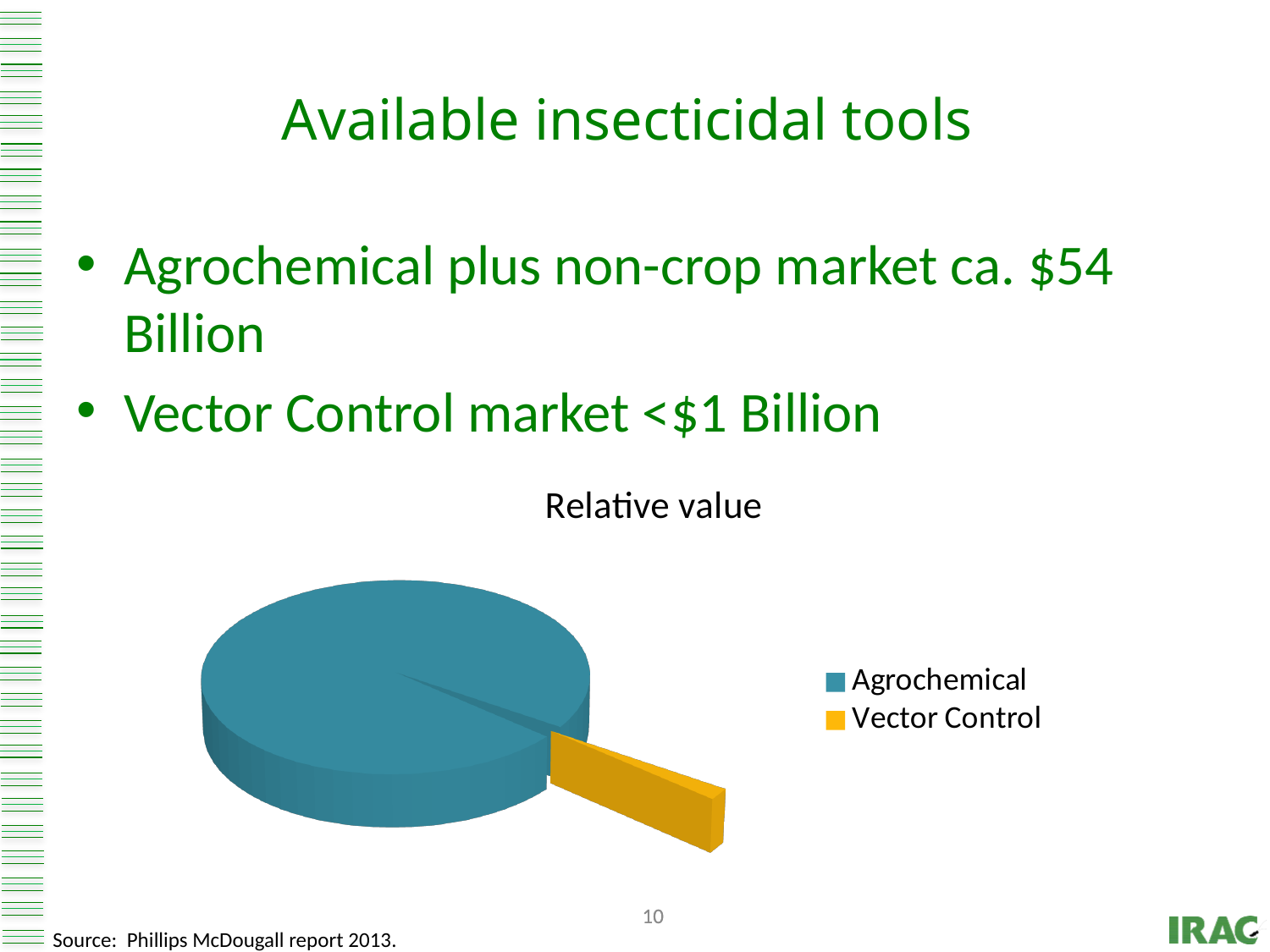
What is the title of the chart? Relative value What kind of chart is shown on the slide? pie chart Which slice of the pie chart is the largest? Agrochemical How many series does the chart legend list? 2 What colour is the Vector Control slice in the pie chart? yellow Which slice of the pie chart is the smallest? Vector Control How many slices does the pie chart have? 2 Which is larger in the pie chart, Agrochemical or Vector Control? Agrochemical